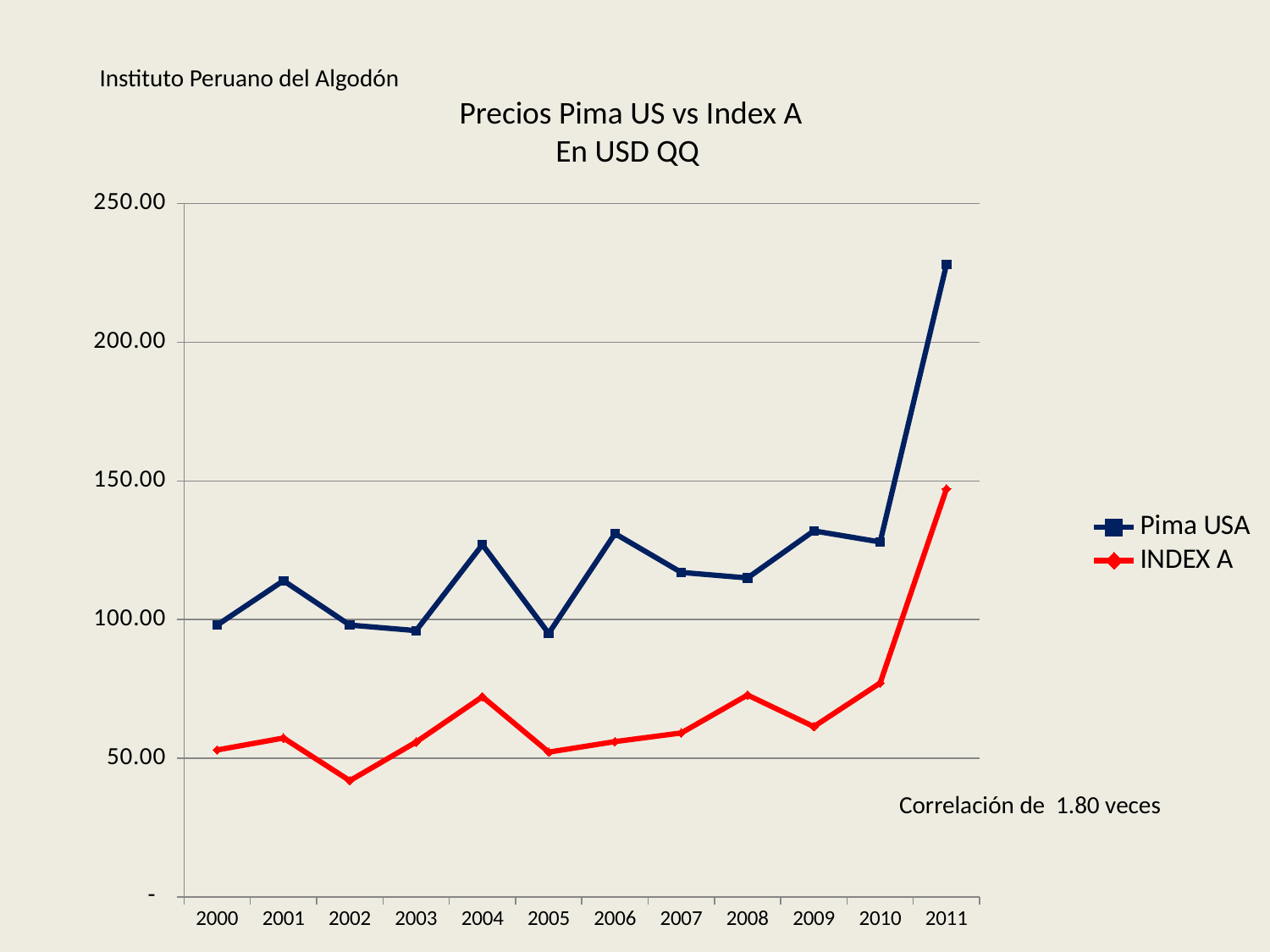
Is the value for INDEX A in 2010 greater or less than 100? less How many years are plotted along the x axis? 12 In which year does the INDEX A series reach its lowest value? 2002 Which series has the larger value in 2005, Pima USA or INDEX A? Pima USA What is the title of the chart? Precios Pima US vs Index A En USD QQ Is the value for Pima USA in 2011 greater or less than 200? greater Does the INDEX A series rise or fall from 2008 to 2009? fall In which year does the Pima USA series reach its highest value? 2011 In which year does the INDEX A series reach its highest value? 2011 Is the value for INDEX A in 2002 greater or less than 50? less What kind of chart is shown on the slide? line chart How many series does the legend list? 2